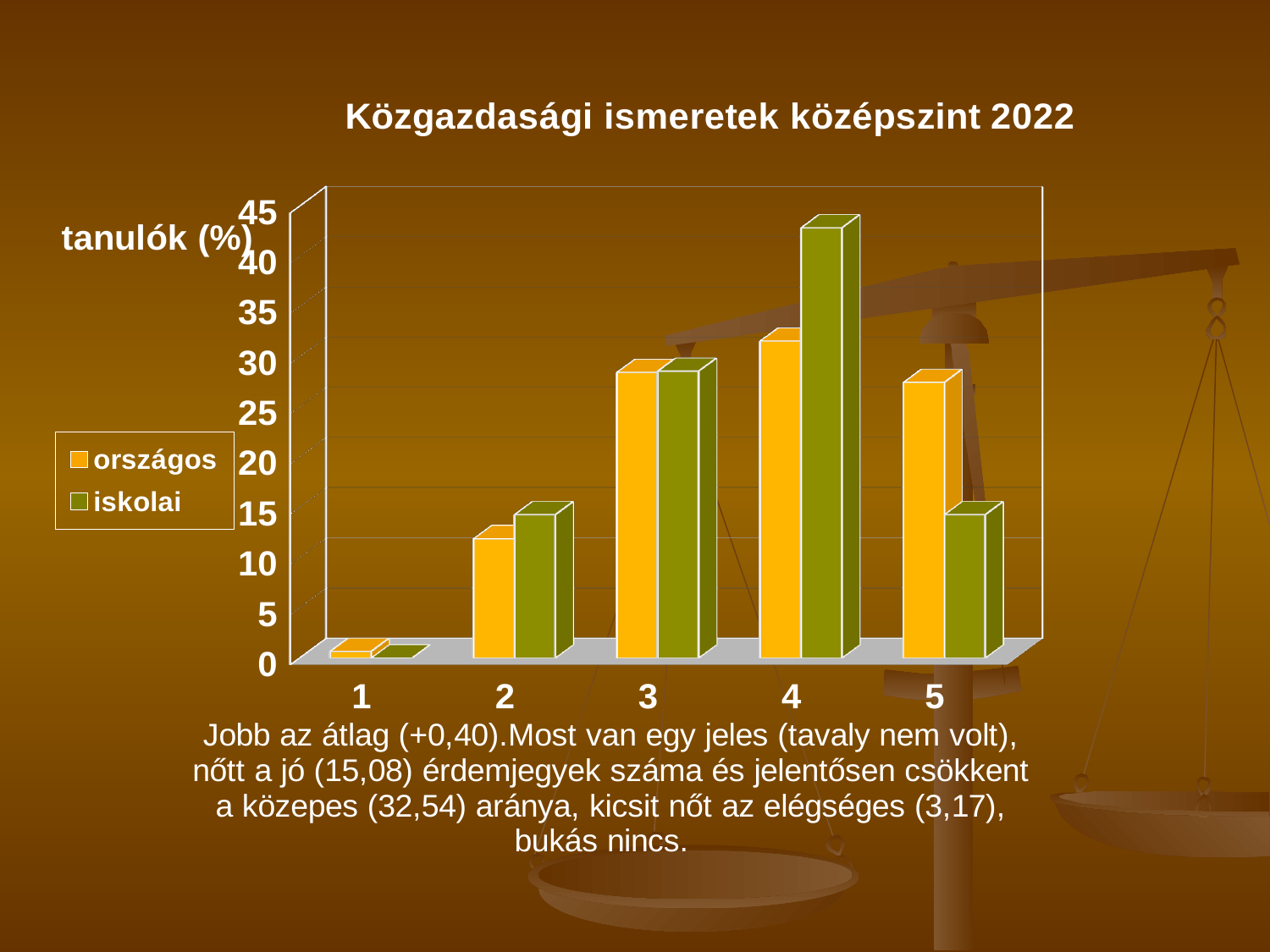
What is the title of the chart? Közgazdasági ismeretek középszint 2022 For which category is the országos value lowest? 1 Which series are listed in the legend? országos, iskolai How many categories are shown on the x axis? 5 For which category is the iskolai value highest? 4 Is the országos value for category 2 greater or less than 15? less For category 5, which is larger: országos or iskolai? országos What kind of chart is shown on the slide? bar chart How many series does the legend list? 2 Is the iskolai value for category 4 greater or less than 40? greater Is the iskolai value for category 5 greater or less than 20? less For category 4, which is larger: országos or iskolai? iskolai